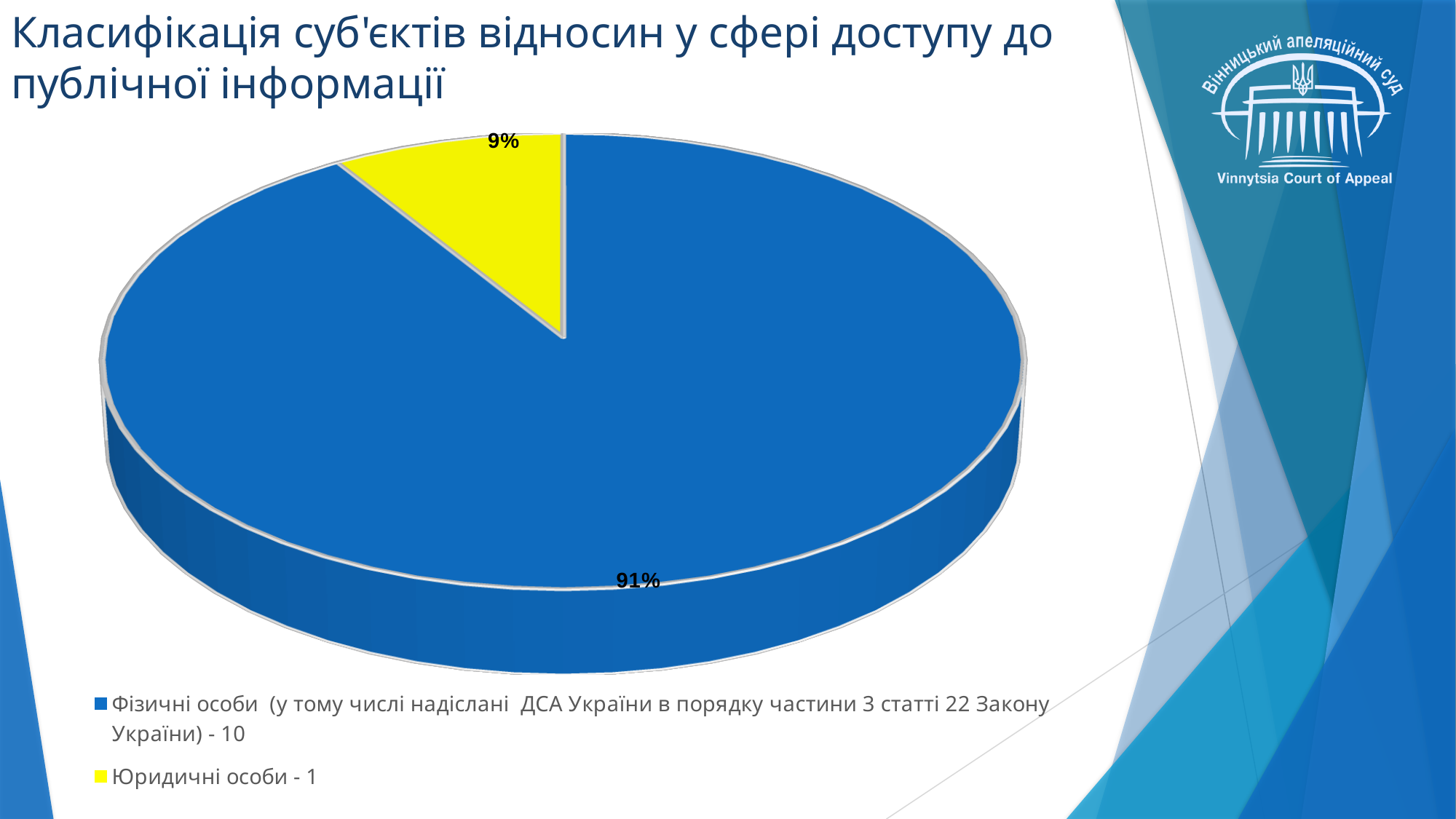
What kind of chart is shown on the slide? Pie chart Which category has the smallest slice of the pie? Юридичні особи How many slices does the pie chart have? 2 What colour is the slice for Юридичні особи? Yellow Which category has the largest slice of the pie? Фізичні особи What is the difference in percentage points between the Фізичні особи slice and the Юридичні особи slice? 82 What share of the pie is labelled for Юридичні особи? 9% What share of the pie is labelled for Фізичні особи? 91% What count is given in the legend for Фізичні особи? 10 What count is given in the legend for Юридичні особи? 1 Which slice is larger: Фізичні особи or Юридичні особи? Фізичні особи How many entries does the legend list? 2